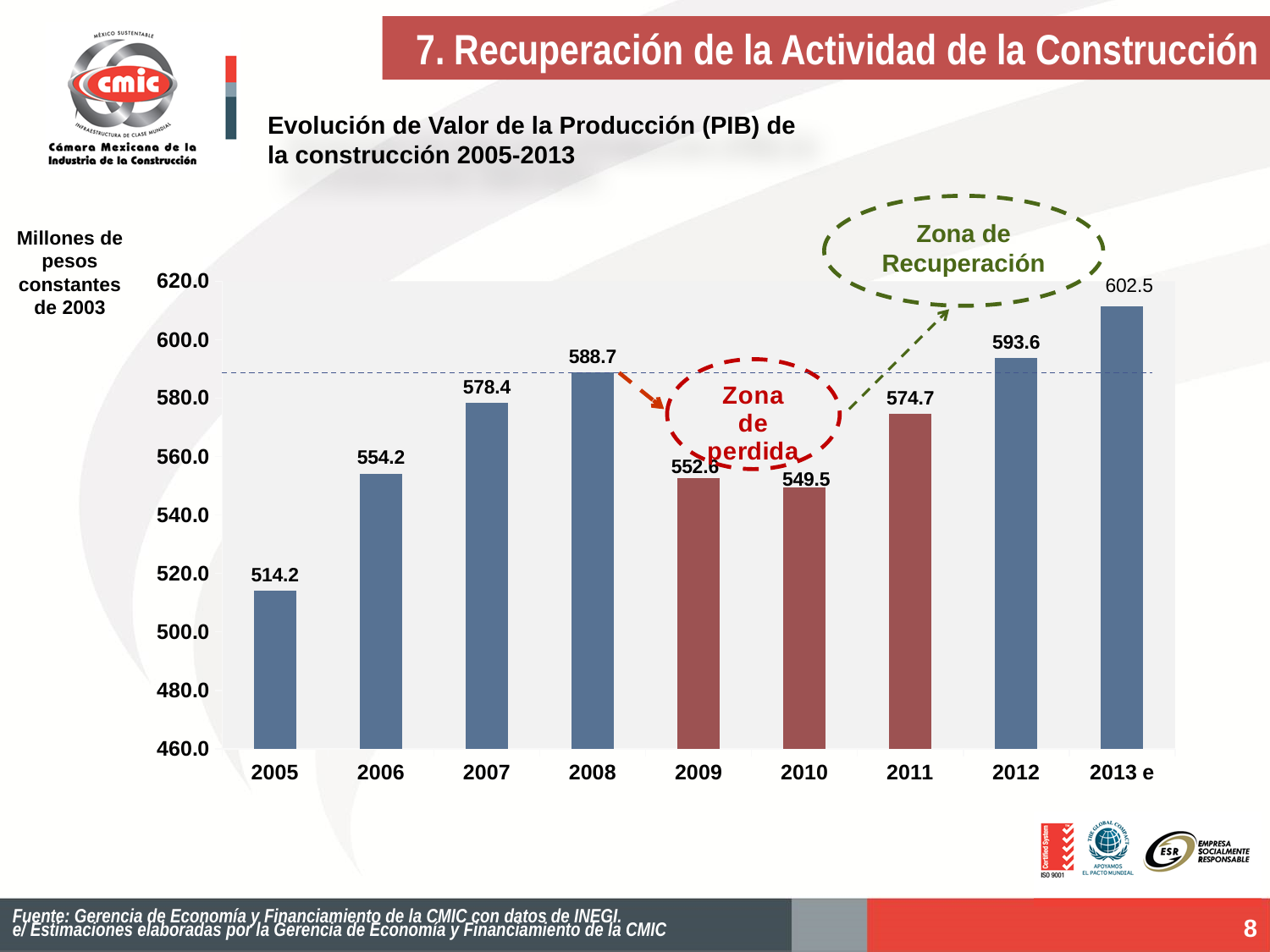
What is the value for 2013 e? 602.5 Which year has the highest value? 2013 e Do the values rise or fall from 2005 to 2008? rise What is the difference between the values for 2008 and 2009? 36.1 What is the value for 2010? 549.5 Is the value for 2012 greater or less than 580.0? greater How many years are shown on the x axis? 9 Which year has the lowest value? 2005 What is the difference between the values for 2013 e and 2005? 88.3 What is the value for 2008? 588.7 Which is larger, the value for 2007 or the value for 2011? 2007 What kind of chart is shown on the slide? bar chart